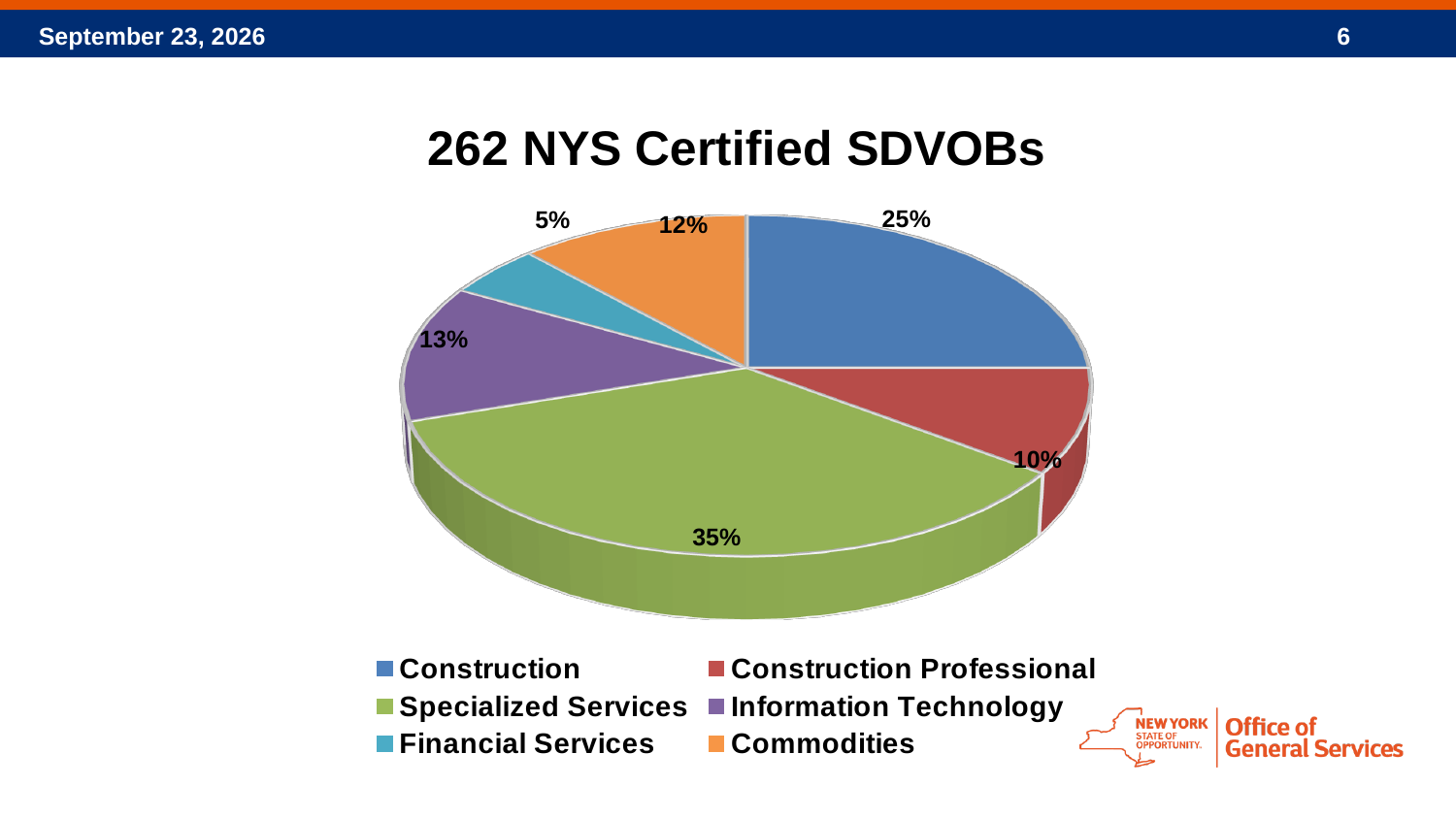
Which category has the smallest slice of the pie? Financial Services What percentage is shown for Commodities? 12% What share of the pie does Construction represent? 25% Which category has the largest slice of the pie? Specialized Services What kind of chart is shown on the slide? pie chart What is the title of the chart? 262 NYS Certified SDVOBs What percentage is shown for Information Technology? 13% What is the difference in percentage points between Specialized Services and Construction? 10 What percentage is shown for Construction Professional? 10% How many categories does the legend list? 6 Which is larger, the share for Information Technology or the share for Commodities? Information Technology What share of the pie does Specialized Services represent? 35%